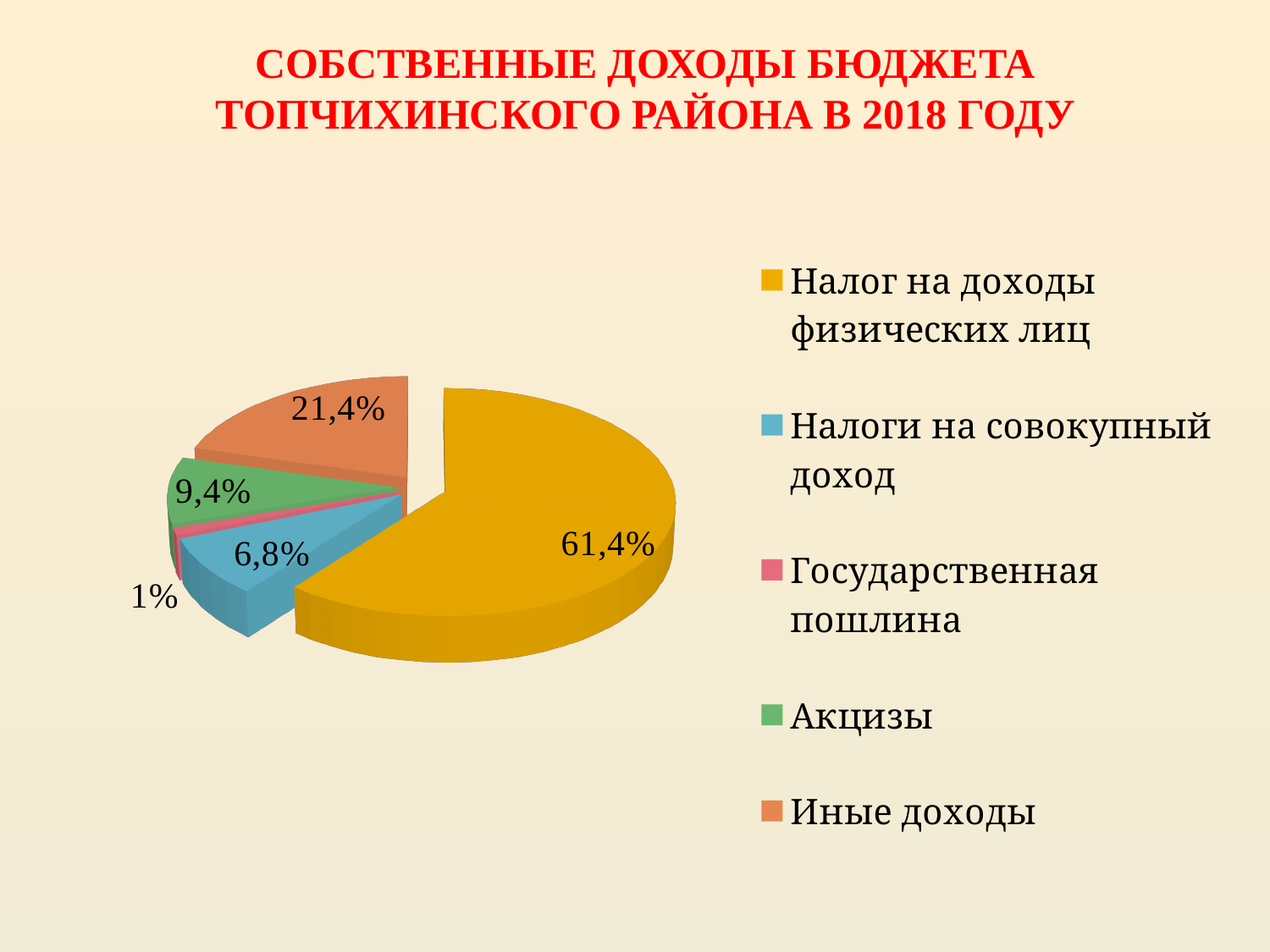
What is the value for Акцизы? 9,4% What is the difference between the shares of Иные доходы and Акцизы? 12 percentage points Which category has the smallest slice of the pie? Государственная пошлина Which category has the largest slice of the pie? Налог на доходы физических лиц What kind of chart is shown on the slide? Pie chart What share of the pie does Налог на доходы физических лиц have? 61,4% What is the value for Иные доходы? 21,4% What colour is the slice for Налог на доходы физических лиц? Yellow What is the value for Налоги на совокупный доход? 6,8% How many categories does the pie chart show? 5 Which is larger, Акцизы or Налоги на совокупный доход? Акцизы What is the value for Государственная пошлина? 1%